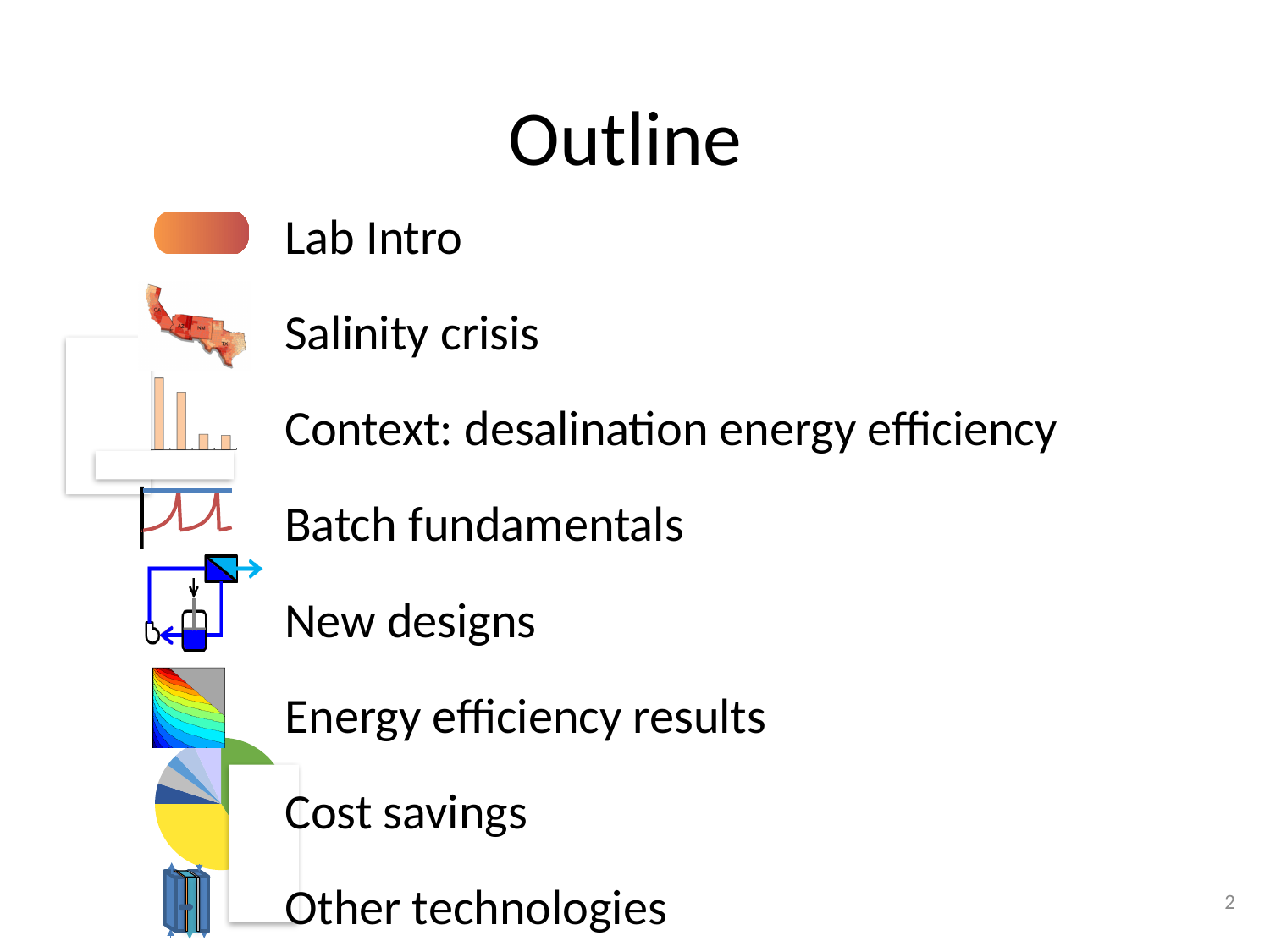
What kind of chart is the small icon next to the outline item "Context: desalination energy efficiency"? bar chart What kind of chart is the small icon next to the outline item "Cost savings"? pie chart How many bars are shown in the small bar chart icon next to "Context: desalination energy efficiency"? 4 In the small bar chart icon next to "Context: desalination energy efficiency", is the tallest bar on the left or the right? left What colour is the largest slice of the small pie chart icon next to "Cost savings"? yellow In the small bar chart icon next to "Context: desalination energy efficiency", do the bars generally rise or fall from left to right? fall